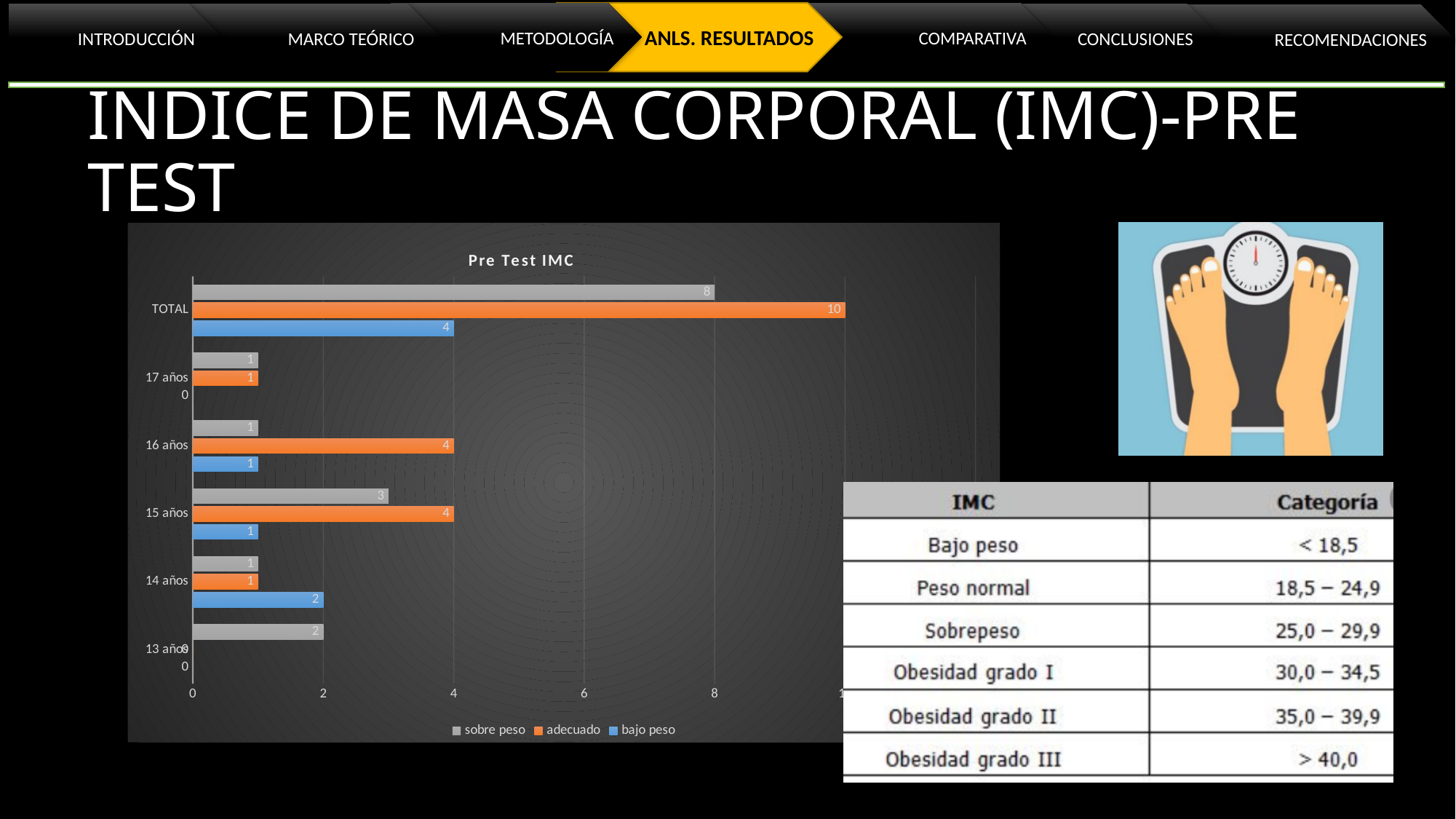
In the Pre Test IMC chart, what is the value of sobre peso for 15 años? 3 In the Pre Test IMC chart, which series has the highest value for TOTAL? adecuado In the Pre Test IMC chart, which series has the lowest value for TOTAL? bajo peso In the Pre Test IMC chart, which is larger for 15 años: sobre peso or adecuado? adecuado In the Pre Test IMC chart, what is the value of adecuado for TOTAL? 10 How many series does the legend of the Pre Test IMC chart list? 3 What kind of chart is the Pre Test IMC chart? bar chart In the Pre Test IMC chart, what is the difference between adecuado and bajo peso for TOTAL? 6 How many categories are shown on the vertical axis of the Pre Test IMC chart? 6 In the Pre Test IMC chart, what is the value of adecuado for 16 años? 4 In the Pre Test IMC chart, what is the value of bajo peso for 14 años? 2 In the Pre Test IMC chart, what is the value of sobre peso for TOTAL? 8